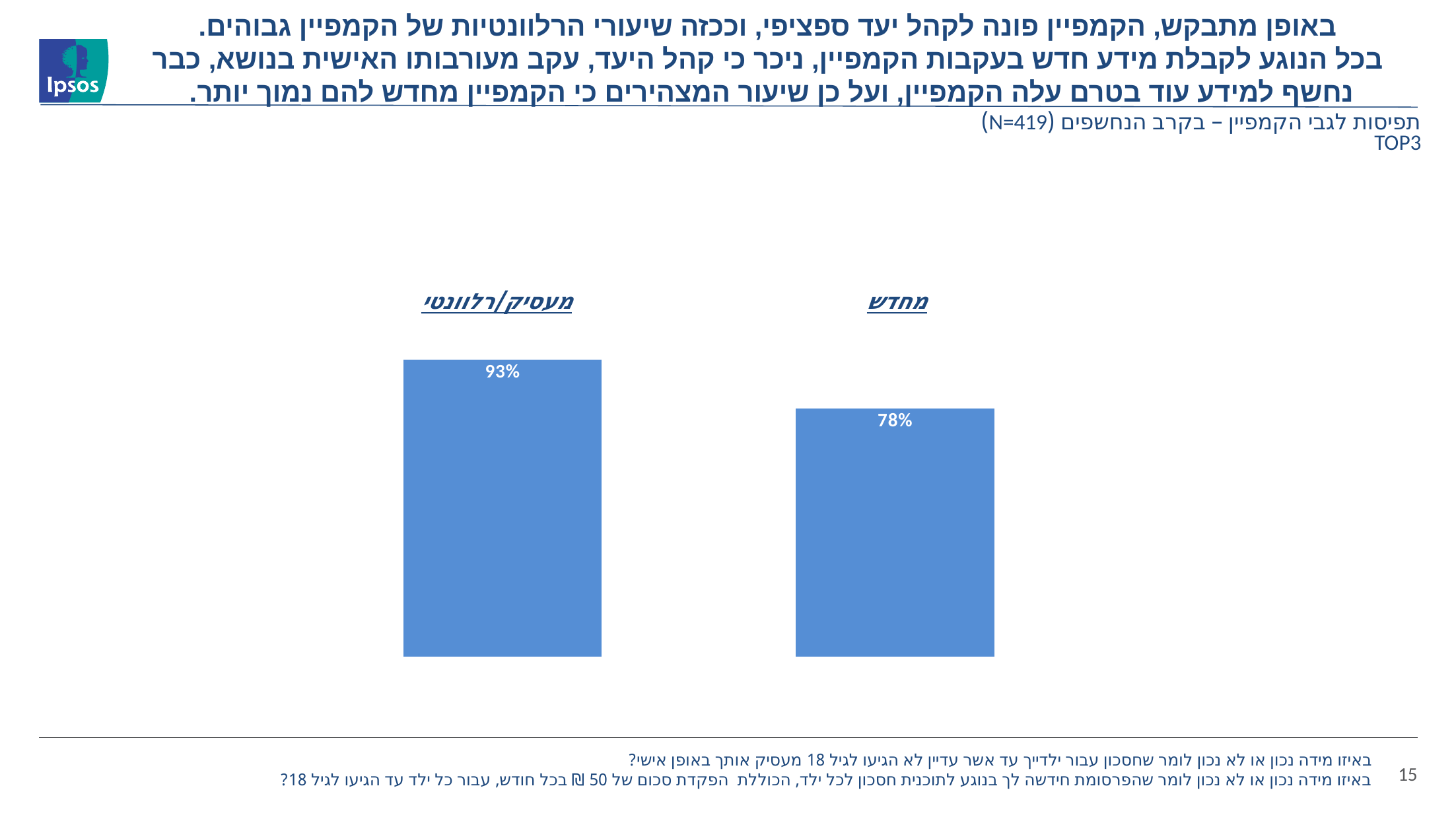
What is the value shown for מעסיק/רלוונטי? 93% What kind of chart is shown on the slide? bar chart What is the sample size (N) stated in the chart subtitle? 419 Which is larger, the value for מעסיק/רלוונטי or the value for מחדש? מעסיק/רלוונטי Which category has the highest value? מעסיק/רלוונטי What is the value shown for מחדש? 78% How many bars are shown in the chart? 2 What is the difference between the values for מעסיק/רלוונטי and מחדש? 15% What colour are the bars in the chart? blue Which category has the lowest value? מחדש